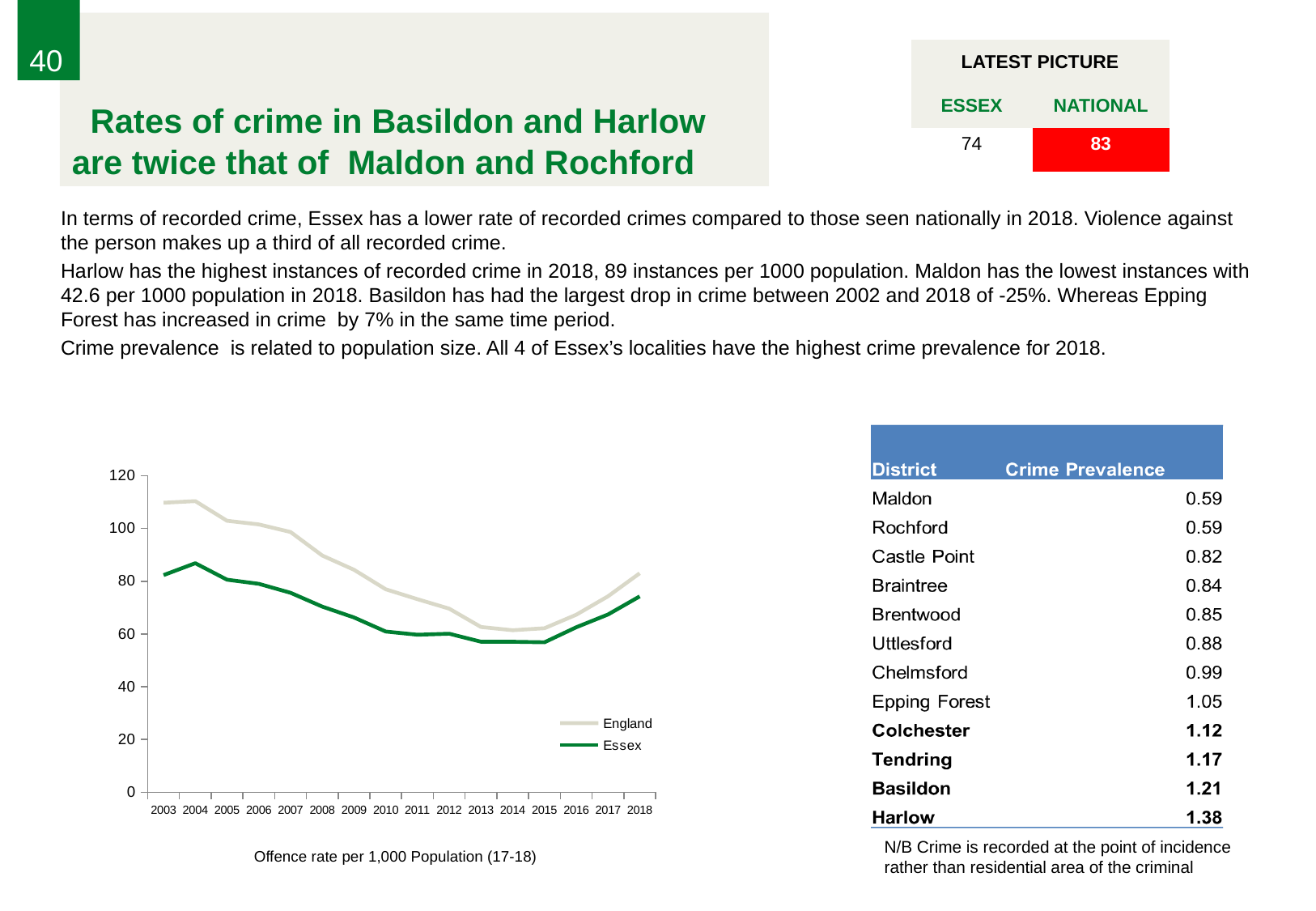
How many series does the chart's legend list? 2 Is the value for England in 2008 greater or less than 80? greater Which series is higher in 2010, England or Essex? England Is the value for Essex in 2018 greater or less than 80? less Does the Essex series rise or fall between 2004 and 2013? fall How many years are plotted along the x axis of the chart? 16 What kind of chart is shown on the slide? line chart In which year does the Essex series reach its highest value? 2004 Is the value for England in 2004 greater or less than 100? greater What is the caption printed beneath the chart? Offence rate per 1,000 Population (17-18) Does the England series rise or fall between 2015 and 2018? rise